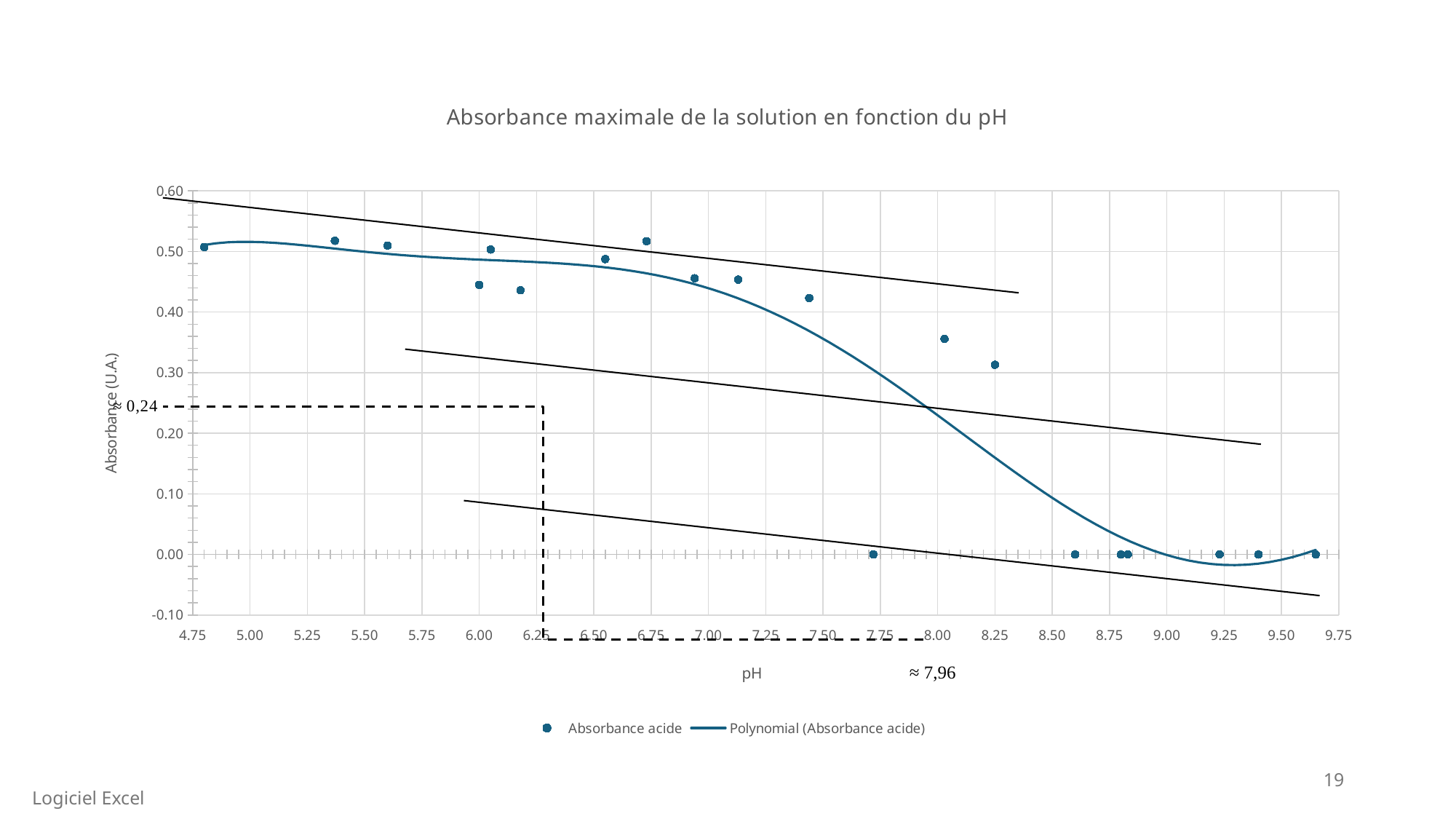
What pH value is marked by the dashed annotation on the x axis? ≈ 7,96 Is the absorbance value for the point at pH 9.40 greater or less than 0.10? less Which point has the higher absorbance: the one at pH 4.80 or the one at pH 8.25? pH 4.80 Is the absorbance value for the point at pH 7.45 greater or less than 0.30? greater Is the absorbance value for the point at pH 8.25 greater or less than 0.40? less What is the title of the chart? Absorbance maximale de la solution en fonction du pH Which point has the higher absorbance: the one at pH 6.05 or the one at pH 6.18? pH 6.05 Overall, do the absorbance values rise or fall as pH increases along the x axis? Fall What kind of chart is shown on the slide? Scatter chart How many series does the legend list? 2